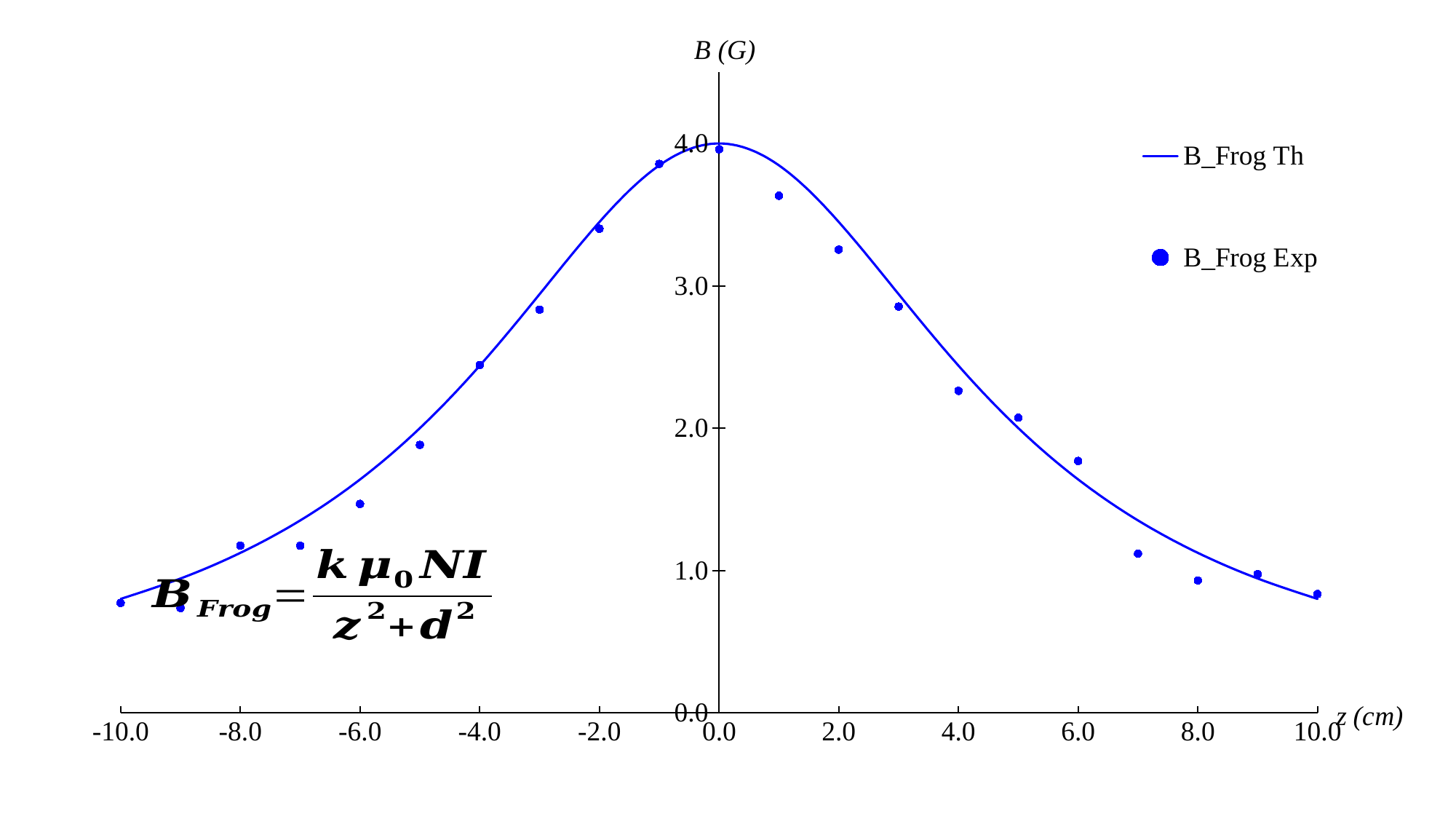
How many series does the legend list? 2 Is the B_Frog Exp value at z = 6.0 greater or less than 2.0? less Which has the larger B_Frog Exp value: z = -6.0 or z = 6.0? z = 6.0 Is the B_Frog Exp value at z = 10.0 greater or less than 1.0? less What kind of chart is shown on the slide? line chart with scatter points Do the B_Frog Th values rise or fall as z increases from 0.0 to 10.0? fall At which z value does the B_Frog Exp series reach its highest point? 0.0 What is the label of the vertical axis? B (G) Is the B_Frog Exp value at z = -4.0 greater or less than 2.0? greater Which has the larger B_Frog Exp value: z = -1.0 or z = 1.0? z = -1.0 What are the two legend entries on the chart? B_Frog Th and B_Frog Exp